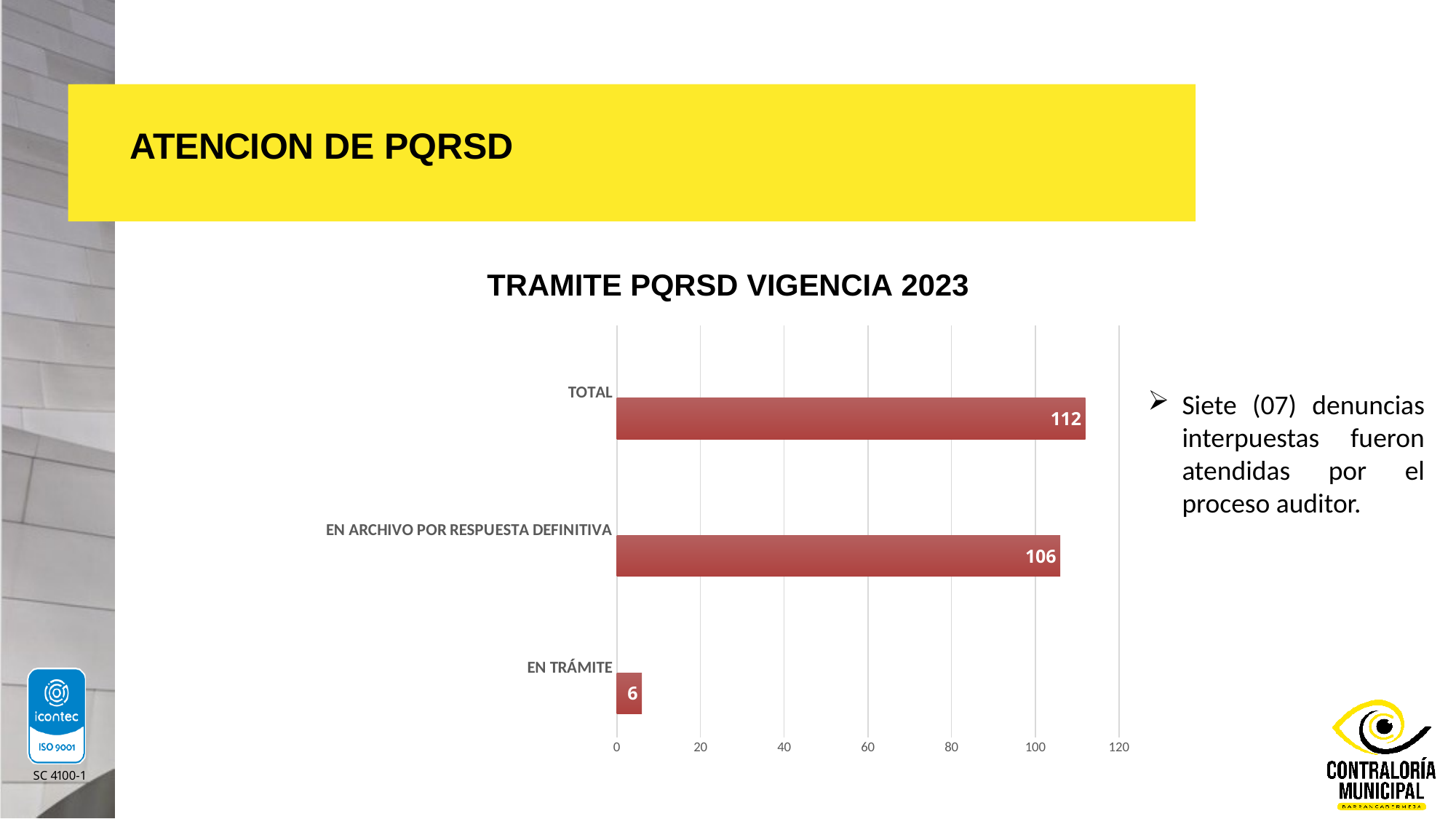
What is the title of the chart? TRAMITE PQRSD VIGENCIA 2023 What is the value for TOTAL? 112 What is the value for EN TRÁMITE? 6 Which category has the lowest value? EN TRÁMITE What is the difference between EN ARCHIVO POR RESPUESTA DEFINITIVA and EN TRÁMITE? 100 What is the value for EN ARCHIVO POR RESPUESTA DEFINITIVA? 106 Is the value for EN ARCHIVO POR RESPUESTA DEFINITIVA greater or less than 100? greater What is the difference between TOTAL and EN ARCHIVO POR RESPUESTA DEFINITIVA? 6 Which category has the highest value? TOTAL How many categories are shown in the chart? 3 What kind of chart is shown on the slide? Bar chart Which is larger, EN ARCHIVO POR RESPUESTA DEFINITIVA or EN TRÁMITE? EN ARCHIVO POR RESPUESTA DEFINITIVA